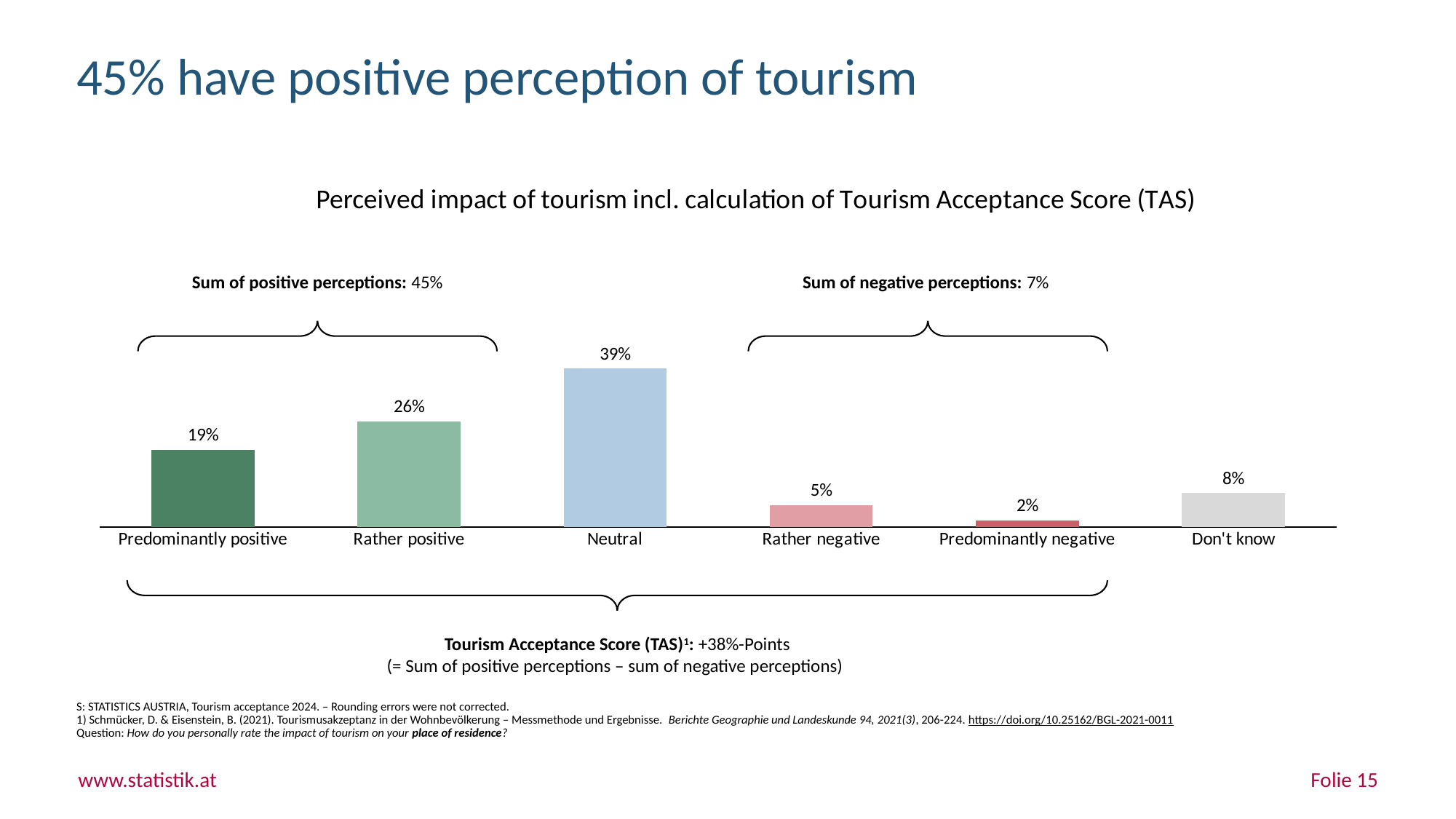
What is the difference between Rather positive and Predominantly positive? 7 percentage points What kind of chart is shown on the slide? Bar chart What is the value for Predominantly positive? 19% What percentage of respondents rated the impact of tourism as Neutral? 39% Which is larger, Don't know or Rather negative? Don't know What is the title of the chart? Perceived impact of tourism incl. calculation of Tourism Acceptance Score (TAS) What is the value for Rather negative? 5% What is the value for Don't know? 8% Which category has the highest value? Neutral What is the sum of positive perceptions shown above the chart? 45% Which category has the lowest value? Predominantly negative How many categories are shown on the x axis? 6